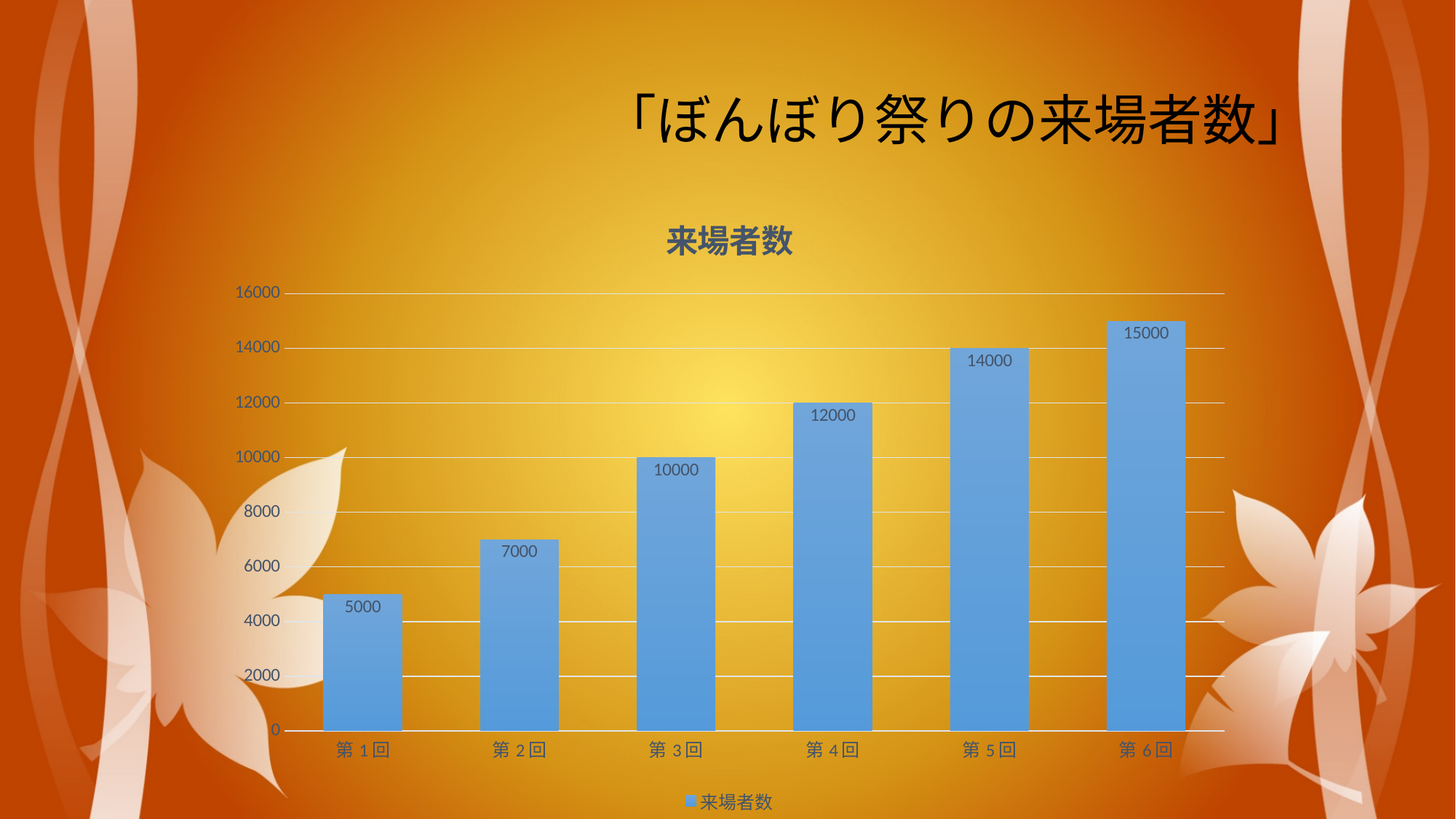
What is the value for 第 1 回? 5000 What kind of chart is shown? bar chart What is the value for 第 4 回? 12000 Which category has the lowest value? 第 1 回 What is the difference between the values for 第 6 回 and 第 1 回? 10000 How many series does the legend list? 1 How many categories are shown on the x axis? 6 What is the value for 第 6 回? 15000 Which category has the highest value? 第 6 回 What is the difference between the values for 第 3 回 and 第 2 回? 3000 Which is larger, the value for 第 5 回 or the value for 第 4 回? 第 5 回 Do the values rise or fall from 第 1 回 to 第 6 回? rise